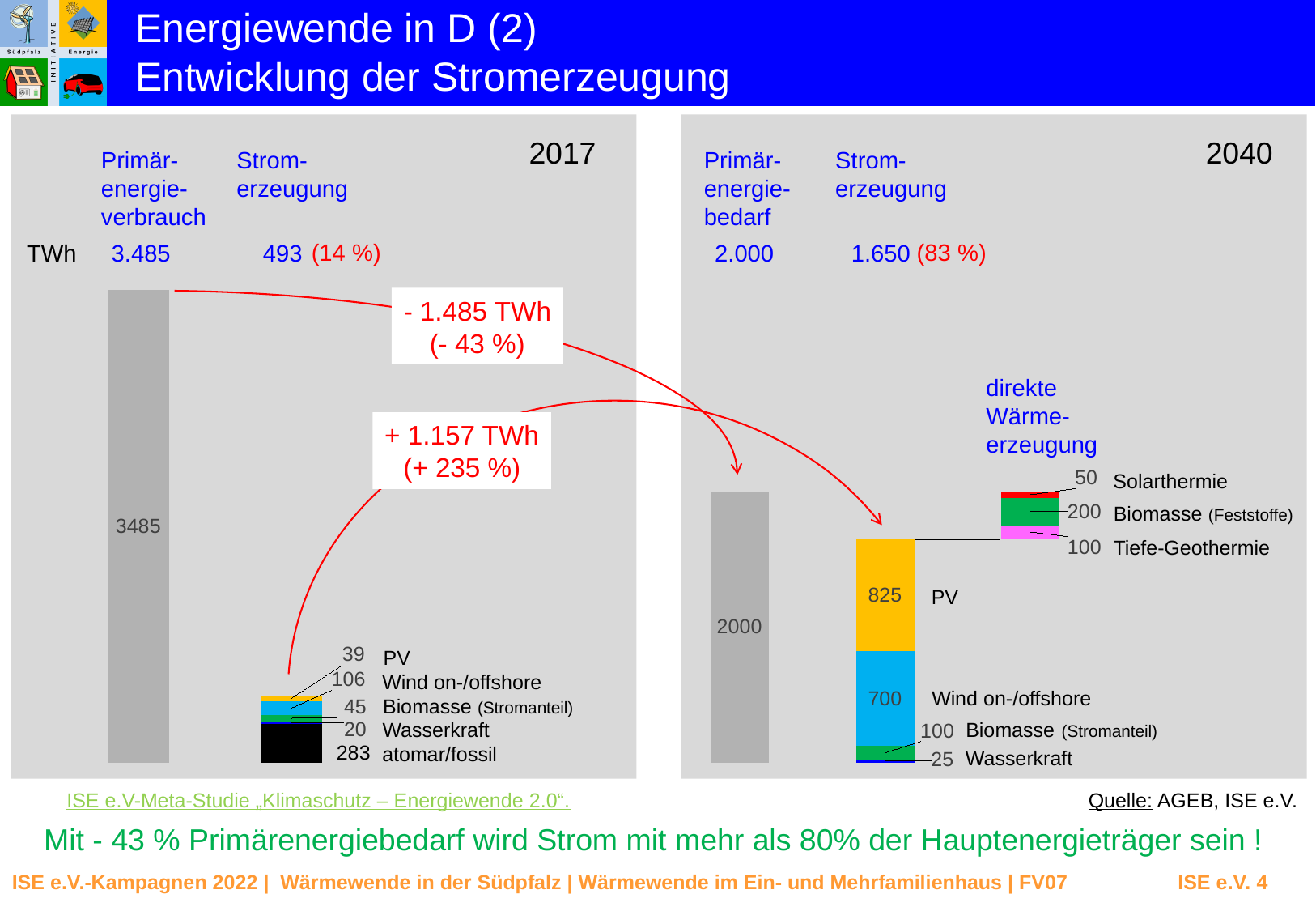
What kind of chart is used to show the Stromerzeugung in the 2017 and 2040 panels? Stacked bar chart In the 2040 chart, which is larger: PV or Wind on-/offshore? PV What is the total of the Stromerzeugung stacked bar in the 2040 chart? 1.650 In the 2017 chart, which segment of the Stromerzeugung bar is the smallest? Wasserkraft In the 2040 chart, what is the value for Wind on-/offshore? 700 What is the difference between the PV values in the 2040 chart and the 2017 chart? 786 In the 2017 chart, what is the value for atomar/fossil in the Stromerzeugung bar? 283 In the 2017 chart, which segment of the Stromerzeugung bar is the largest? atomar/fossil In the 2040 chart, what is the value for Biomasse (Feststoffe) in the direkte Wärmeerzeugung bar? 200 How many segments does the Stromerzeugung stacked bar in the 2017 chart have? 5 In the 2040 chart, which segment of the Stromerzeugung bar is the smallest? Wasserkraft In the 2040 chart, what is the value for PV in the Stromerzeugung bar? 825